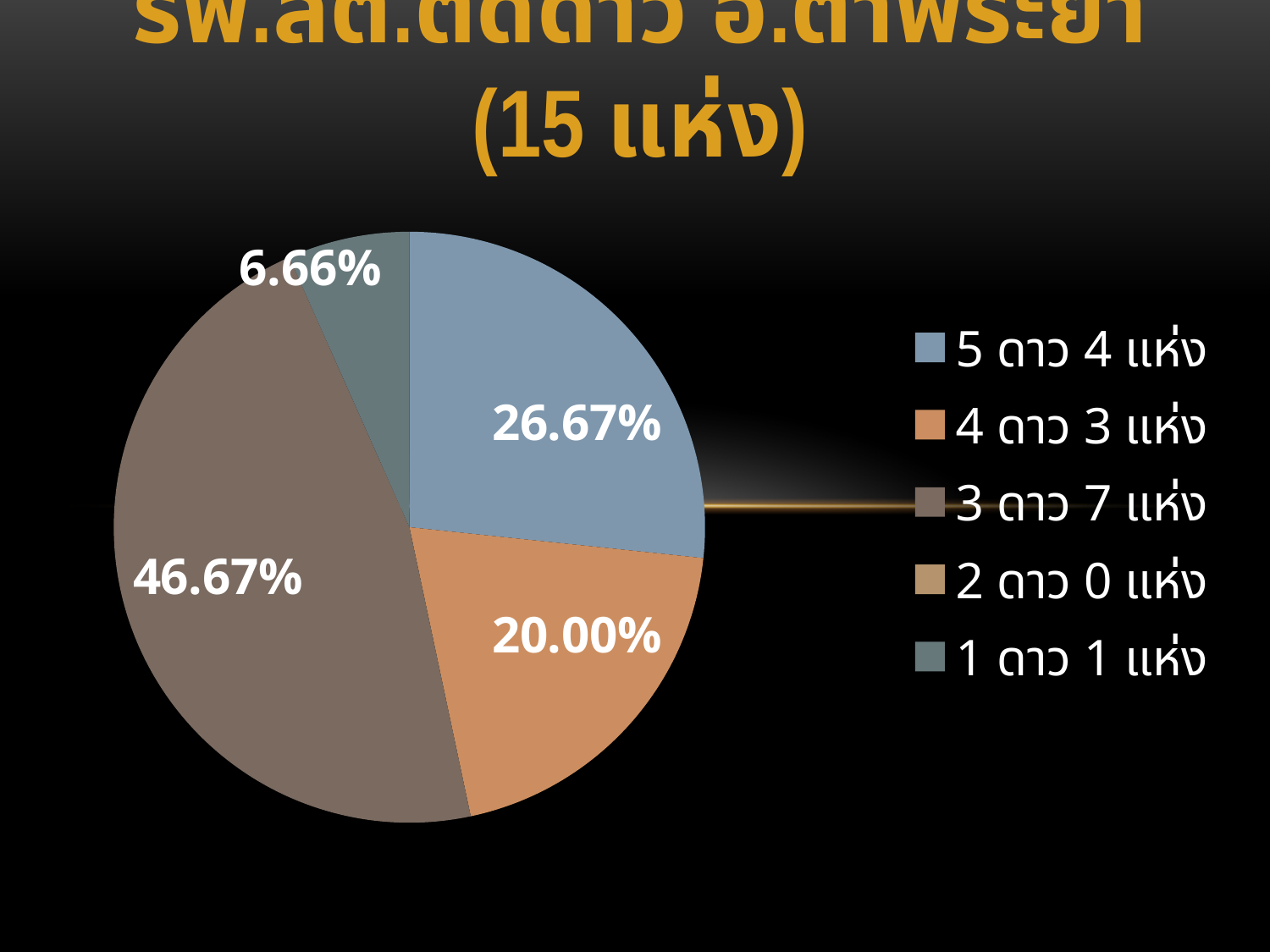
According to the legend, how many แห่ง are in the 2 ดาว category? 0 แห่ง According to the legend, how many แห่ง are in the 3 ดาว category? 7 แห่ง Which category has the largest slice of the pie? 3 ดาว Which category has the smallest visible slice of the pie? 1 ดาว What share of the pie does the 4 ดาว slice represent? 20.00% What is the difference between the 3 ดาว share and the 5 ดาว share? 20.00% Which slice is larger, 5 ดาว or 4 ดาว? 5 ดาว How many entries does the legend list? 5 What share of the pie does the 3 ดาว slice represent? 46.67% What kind of chart is shown on the slide? pie chart What share of the pie does the 1 ดาว slice represent? 6.66%